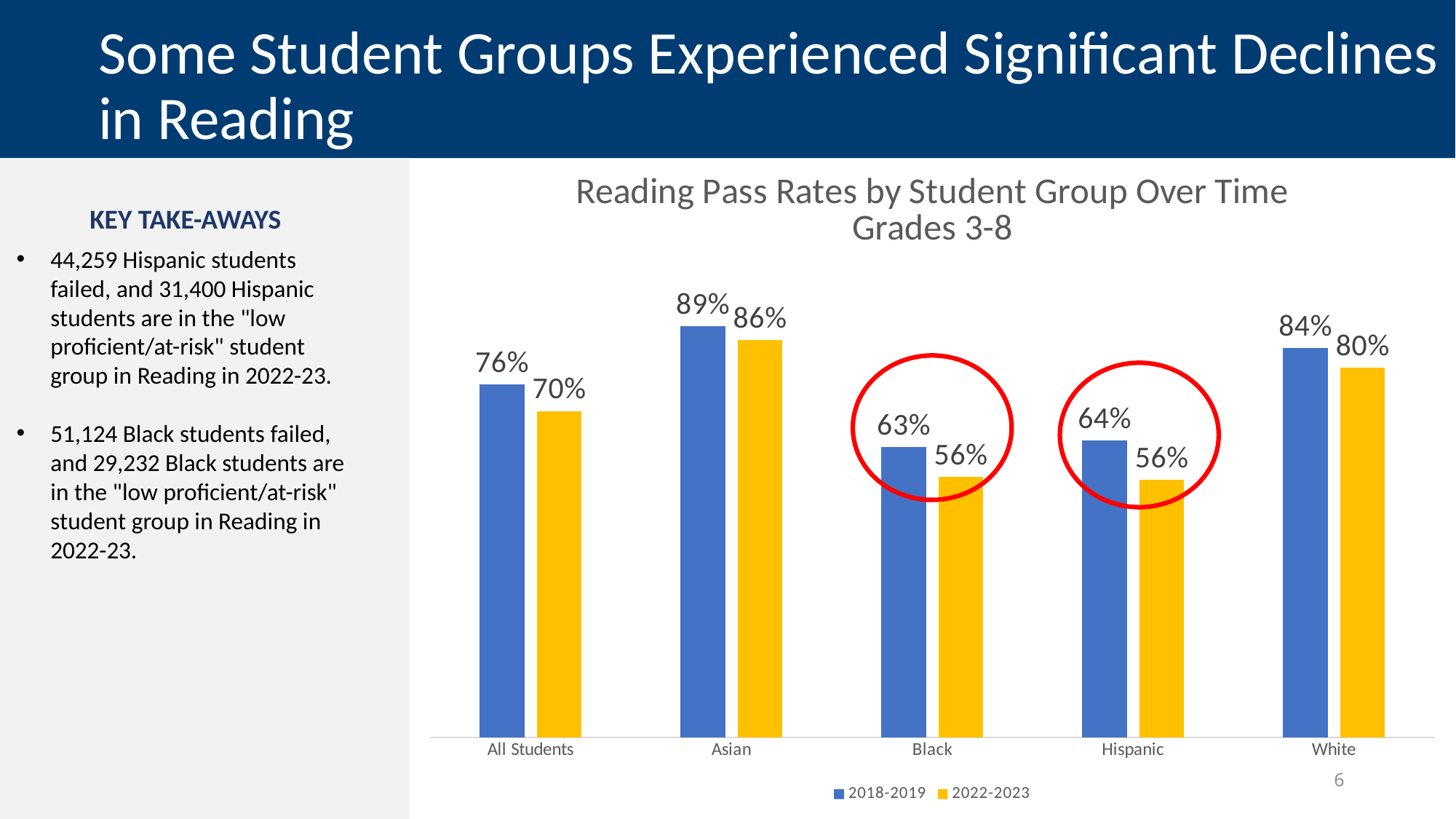
What is the difference between the 2022-2023 reading pass rates for White students and Black students? 24% Which is larger: the 2018-2019 pass rate for Black students or the 2018-2019 pass rate for Hispanic students? Hispanic What was the reading pass rate for Asian students in 2018-2019? 89% Which two student groups are circled in red on the chart? Black and Hispanic By how many percentage points did the reading pass rate for Hispanic students fall from 2018-2019 to 2022-2023? 8 How many series does the chart legend list? 2 What was the reading pass rate for All Students in 2022-2023? 70% Which student group had the lowest reading pass rate in 2018-2019? Black What was the reading pass rate for White students in 2022-2023? 80% How many student groups are shown on the x axis of the chart? 5 Which student group had the highest reading pass rate in 2022-2023? Asian What type of chart is shown on the slide? Bar chart